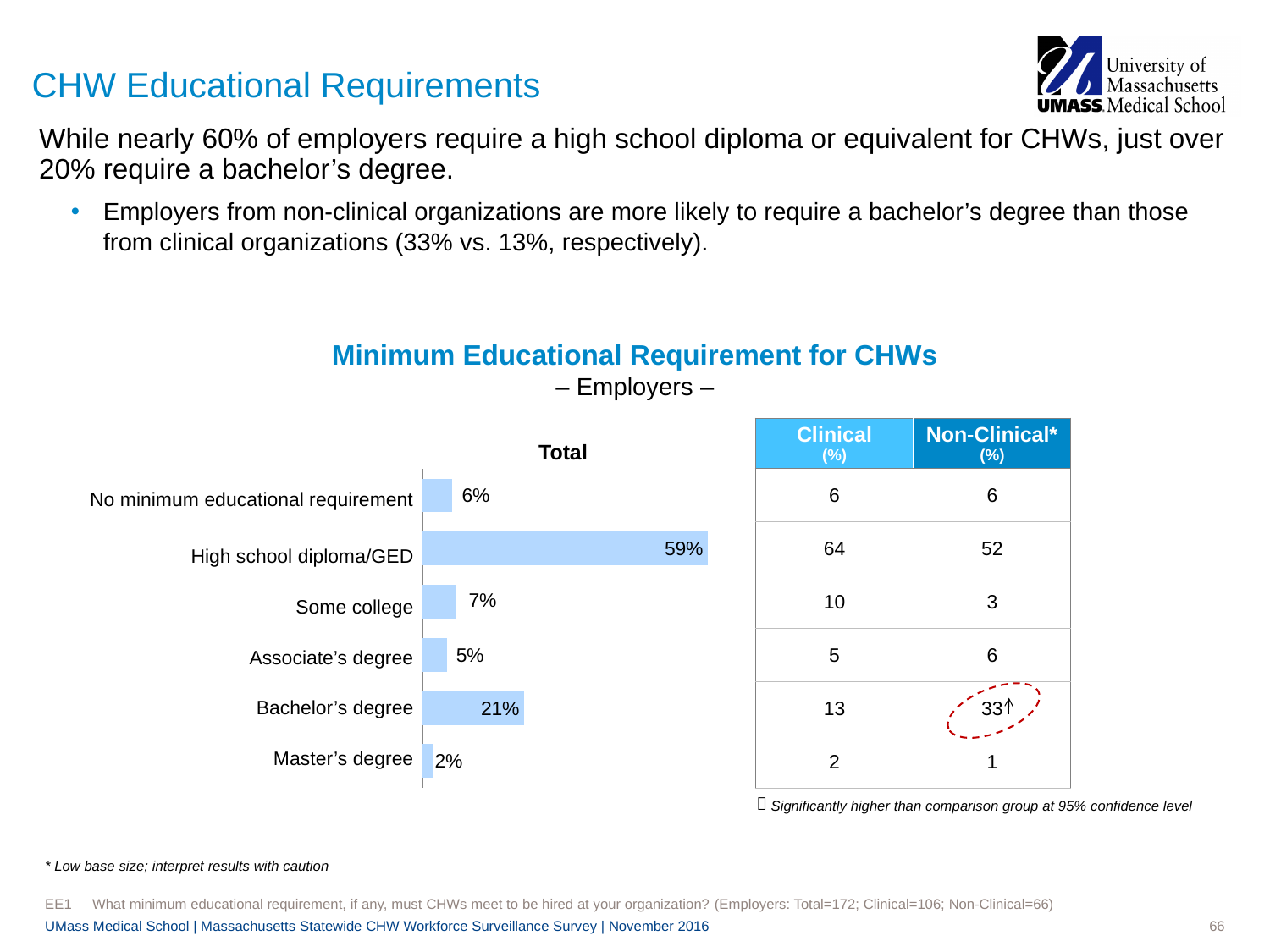
What type of chart is used to show the Total values? Bar chart What is the Total value for Some college? 7% What is the title of the chart? Minimum Educational Requirement for CHWs – Employers – What is the difference between the Total values for High school diploma/GED and Bachelor's degree? 38% What is the Total value for Master's degree? 2% What is the Total value for Bachelor's degree? 21% Which has a larger Total value, Some college or Associate's degree? Some college Which category has the lowest Total value? Master's degree Which category has the highest Total value? High school diploma/GED How many categories are shown in the bar chart? 6 What is the Total value for High school diploma/GED? 59% What is the difference between the Total values for No minimum educational requirement and Associate's degree? 1%